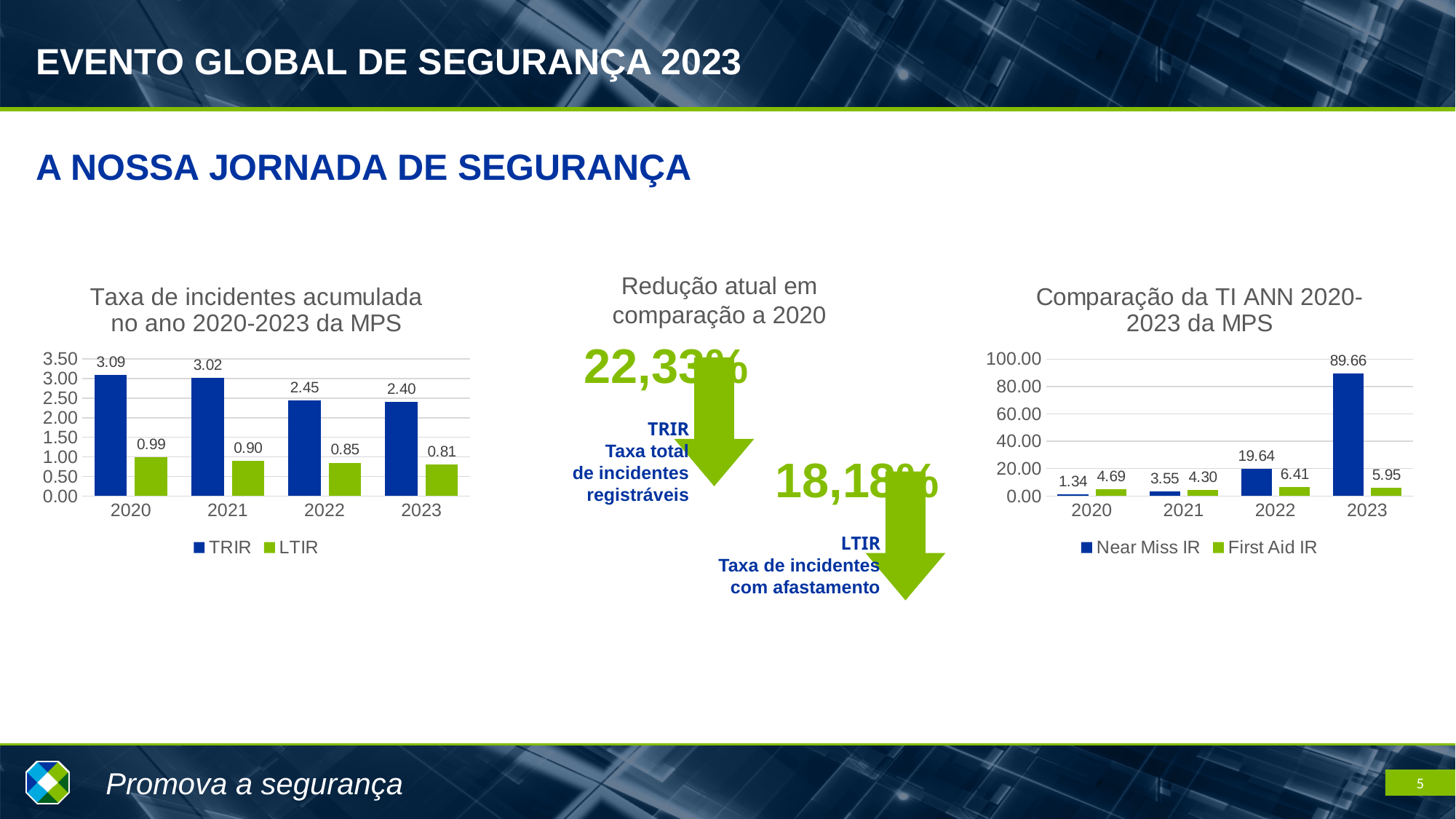
In the chart 'Comparação da TI ANN 2020-2023 da MPS', how many years are shown on the x axis? 4 What kind of chart is 'Comparação da TI ANN 2020-2023 da MPS'? bar chart In the chart 'Taxa de incidentes acumulada no ano 2020-2023 da MPS', does the TRIR value rise or fall from 2020 to 2023? fall In the chart 'Comparação da TI ANN 2020-2023 da MPS', which year has the highest Near Miss IR value? 2023 In the chart 'Comparação da TI ANN 2020-2023 da MPS', what is the First Aid IR value for 2022? 6.41 In the chart 'Taxa de incidentes acumulada no ano 2020-2023 da MPS', what is the difference between the TRIR values for 2020 and 2023? 0.69 In the chart 'Taxa de incidentes acumulada no ano 2020-2023 da MPS', what is the TRIR value for 2020? 3.09 In the chart 'Taxa de incidentes acumulada no ano 2020-2023 da MPS', what is the LTIR value for 2023? 0.81 In the chart 'Taxa de incidentes acumulada no ano 2020-2023 da MPS', how many series does the legend list? 2 In the chart 'Comparação da TI ANN 2020-2023 da MPS', what is the Near Miss IR value for 2023? 89.66 In the chart 'Taxa de incidentes acumulada no ano 2020-2023 da MPS', which year has the lowest TRIR value? 2023 In the chart 'Comparação da TI ANN 2020-2023 da MPS', which is larger in 2021: Near Miss IR or First Aid IR? First Aid IR